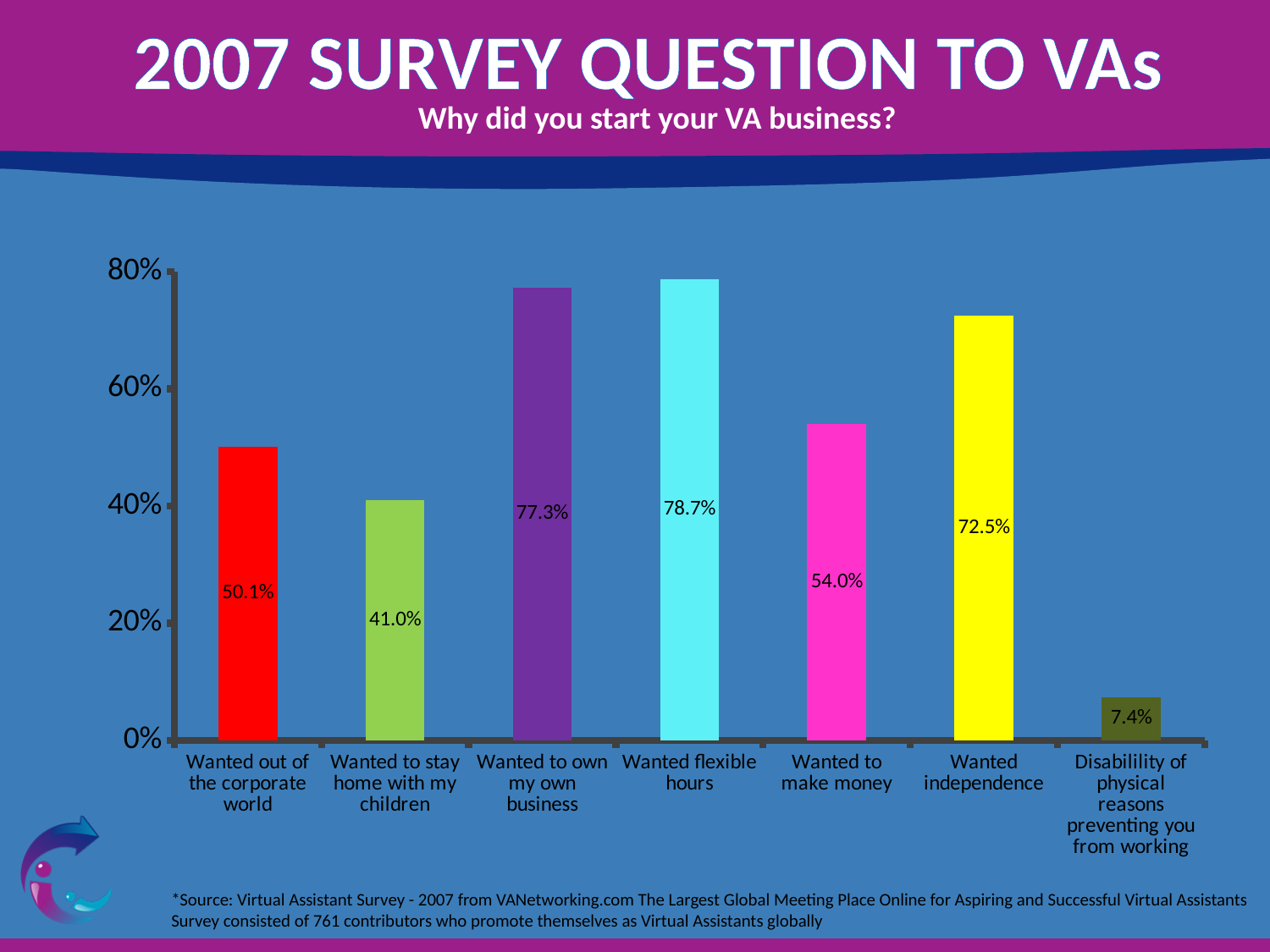
Which is larger: the percentage for 'Wanted out of the corporate world' or for 'Wanted to stay home with my children'? Wanted out of the corporate world Which reason for starting a VA business has the highest percentage? Wanted flexible hours Is the value for 'Wanted to make money' greater or less than 60%? less Which reason for starting a VA business has the lowest percentage? Disabilility of physical reasons preventing you from working What is the survey question shown as the chart's subtitle? Why did you start your VA business? What kind of chart is shown on the slide? Bar chart How many reasons (categories) are shown on the chart? 7 What value is shown for 'Wanted independence'? 72.5% What colour is the bar for 'Wanted independence'? Yellow What percentage of VAs said they started their business because they wanted flexible hours? 78.7% What is the difference in percentage points between 'Wanted to own my own business' and 'Wanted to make money'? 23.3 What percentage of VAs cited wanting to stay home with their children as a reason for starting their VA business? 41.0%